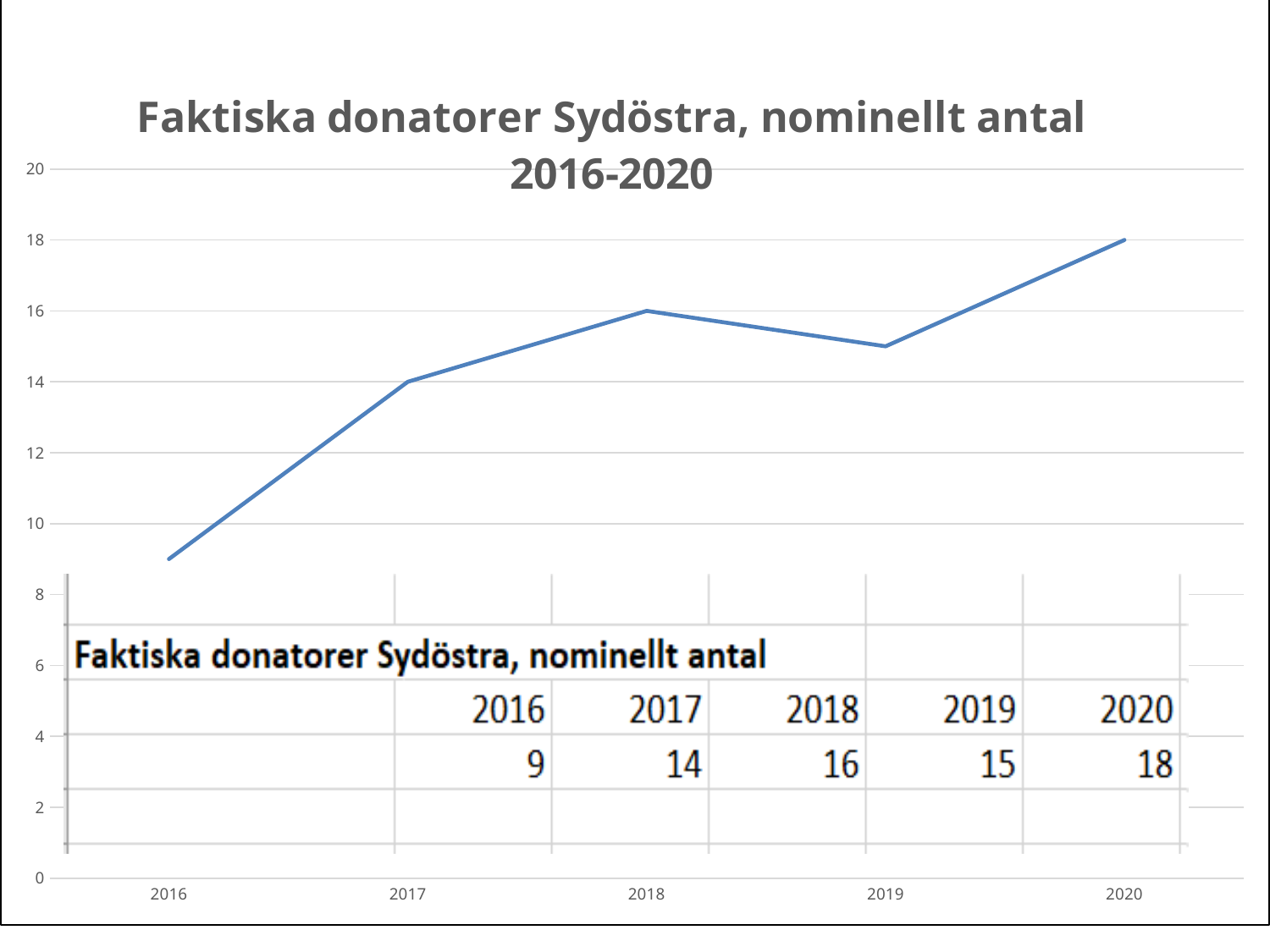
What is the value for 2020? 18 Which is larger, the value for 2017 or the value for 2019? 2019 What is the value for 2016? 9 What kind of chart is shown? line chart Is the value for 2017 greater or less than 12? greater What is the difference between the values for 2020 and 2016? 9 Which year has the lowest value? 2016 Which year has the highest value? 2020 What is the value for 2018? 16 What is the title of the chart? Faktiska donatorer Sydöstra, nominellt antal 2016-2020 How many years are plotted on the chart? 5 What is the difference between the values for 2018 and 2019? 1